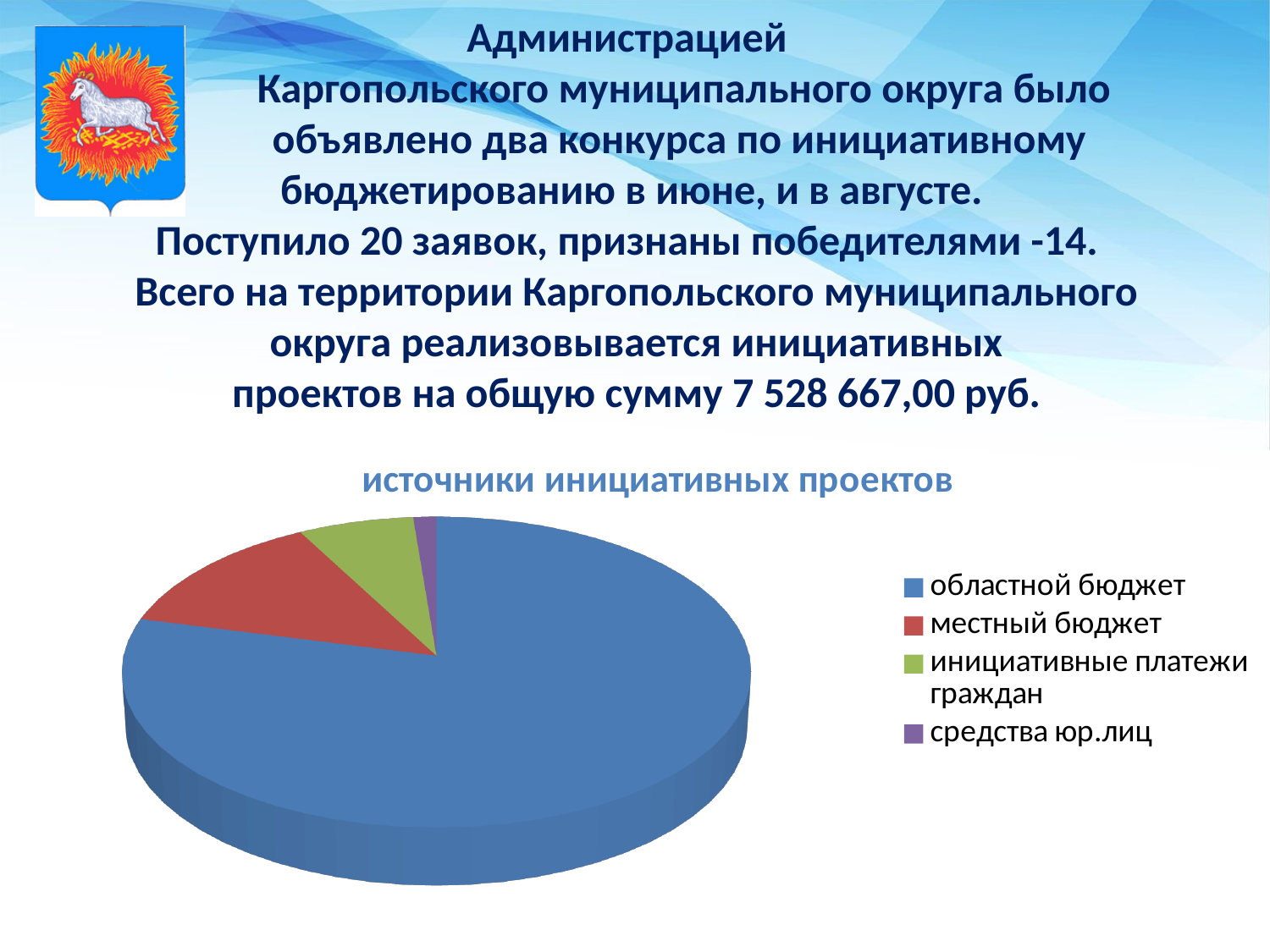
Which slice is larger: местный бюджет or инициативные платежи граждан? местный бюджет How many categories (slices) does the pie chart have? 4 Which category is shown in green in the pie chart? инициативные платежи граждан What is the title of the chart? источники инициативных проектов Which slice is larger: областной бюджет or местный бюджет? областной бюджет Which colour represents местный бюджет in the pie chart? red What kind of chart is shown on the slide? pie chart Which category has the smallest slice of the pie? средства юр.лиц Which category has the largest slice of the pie? областной бюджет Which slice is larger: инициативные платежи граждан or средства юр.лиц? инициативные платежи граждан